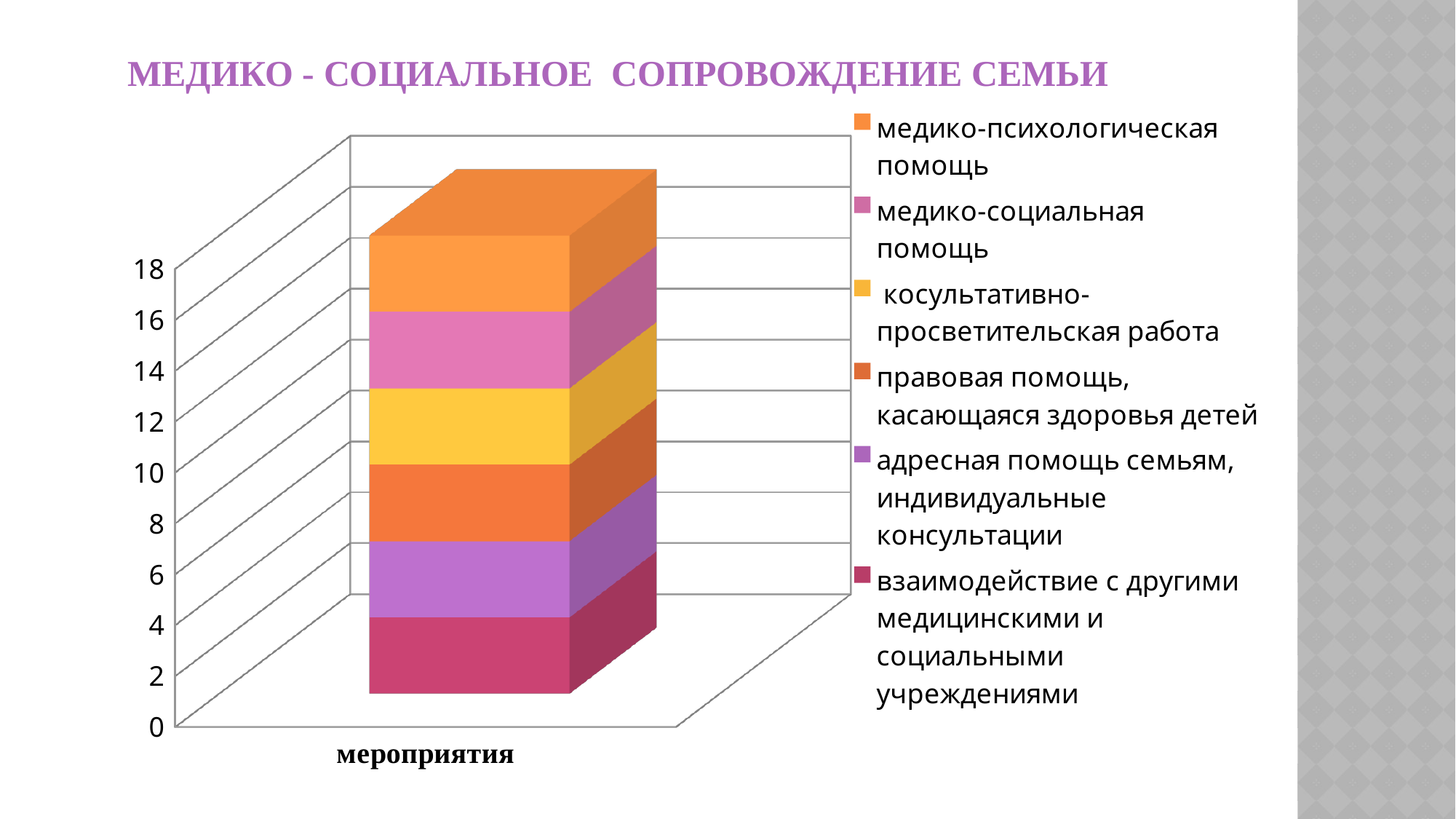
What is the title of the slide containing the chart? МЕДИКО - СОЦИАЛЬНОЕ СОПРОВОЖДЕНИЕ СЕМЬИ Is the total height of the stacked bar for мероприятия greater or less than 10? greater Is the value of the segment for взаимодействие с другими медицинскими и социальными учреждениями greater or less than 6? less Which series forms the bottom segment of the stacked bar? взаимодействие с другими медицинскими и социальными учреждениями What kind of chart is shown on the slide? stacked bar chart How many series does the legend list? 6 How many categories are plotted on the x axis? 1 Is the value of the segment for медико-психологическая помощь greater or less than 8? less